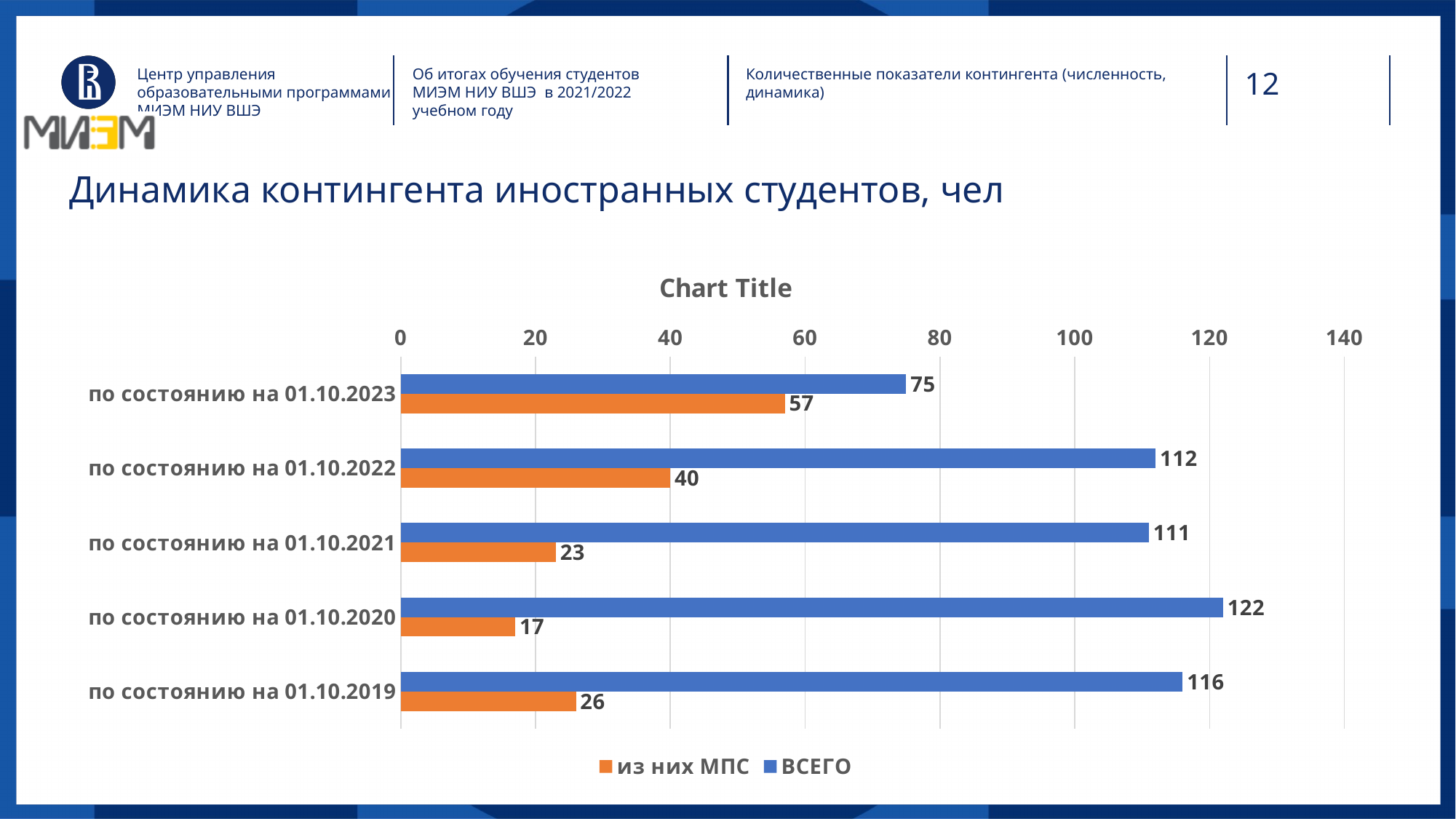
Which category has the highest ВСЕГО value? по состоянию на 01.10.2020 Which is larger: the из них МПС value for по состоянию на 01.10.2019 or for по состоянию на 01.10.2023? по состоянию на 01.10.2023 What is the из них МПС value for по состоянию на 01.10.2021? 23 Which category has the lowest из них МПС value? по состоянию на 01.10.2020 How many series does the legend list? 2 Which colour represents the ВСЕГО series? blue Is the ВСЕГО value for по состоянию на 01.10.2019 greater or less than 100? greater What is the ВСЕГО value for по состоянию на 01.10.2020? 122 How many categories are shown on the chart? 5 What kind of chart is shown on the slide? bar chart What is the ВСЕГО value for по состоянию на 01.10.2023? 75 What is the difference between the ВСЕГО and из них МПС values for по состоянию на 01.10.2022? 72